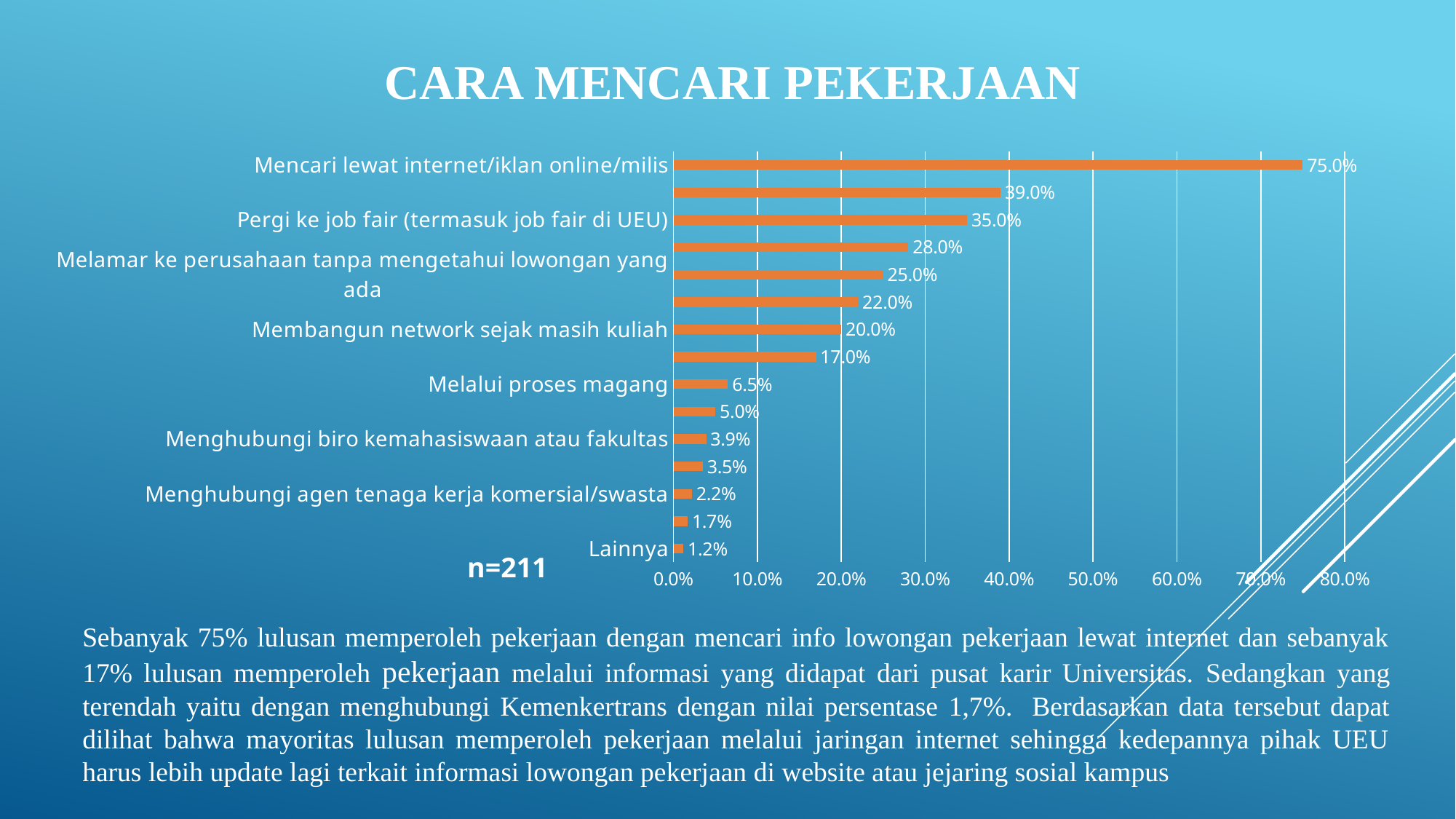
Which category has the lowest value? Lainnya What is the value for "Membangun network sejak masih kuliah"? 20.0% How many bars are plotted in the chart? 15 Which is larger, the value for "Melamar ke perusahaan tanpa mengetahui lowongan yang ada" or the value for "Membangun network sejak masih kuliah"? Melamar ke perusahaan tanpa mengetahui lowongan yang ada What is the value for "Lainnya"? 1.2% What is the value for "Pergi ke job fair (termasuk job fair di UEU)"? 35.0% What is the title of the slide? CARA MENCARI PEKERJAAN Which category has the highest value? Mencari lewat internet/iklan online/milis What is the difference between the values for "Mencari lewat internet/iklan online/milis" and "Pergi ke job fair (termasuk job fair di UEU)"? 40.0% What kind of chart is shown on the slide? Bar chart What is the value for "Melalui proses magang"? 6.5% What is the value for "Mencari lewat internet/iklan online/milis"? 75.0%